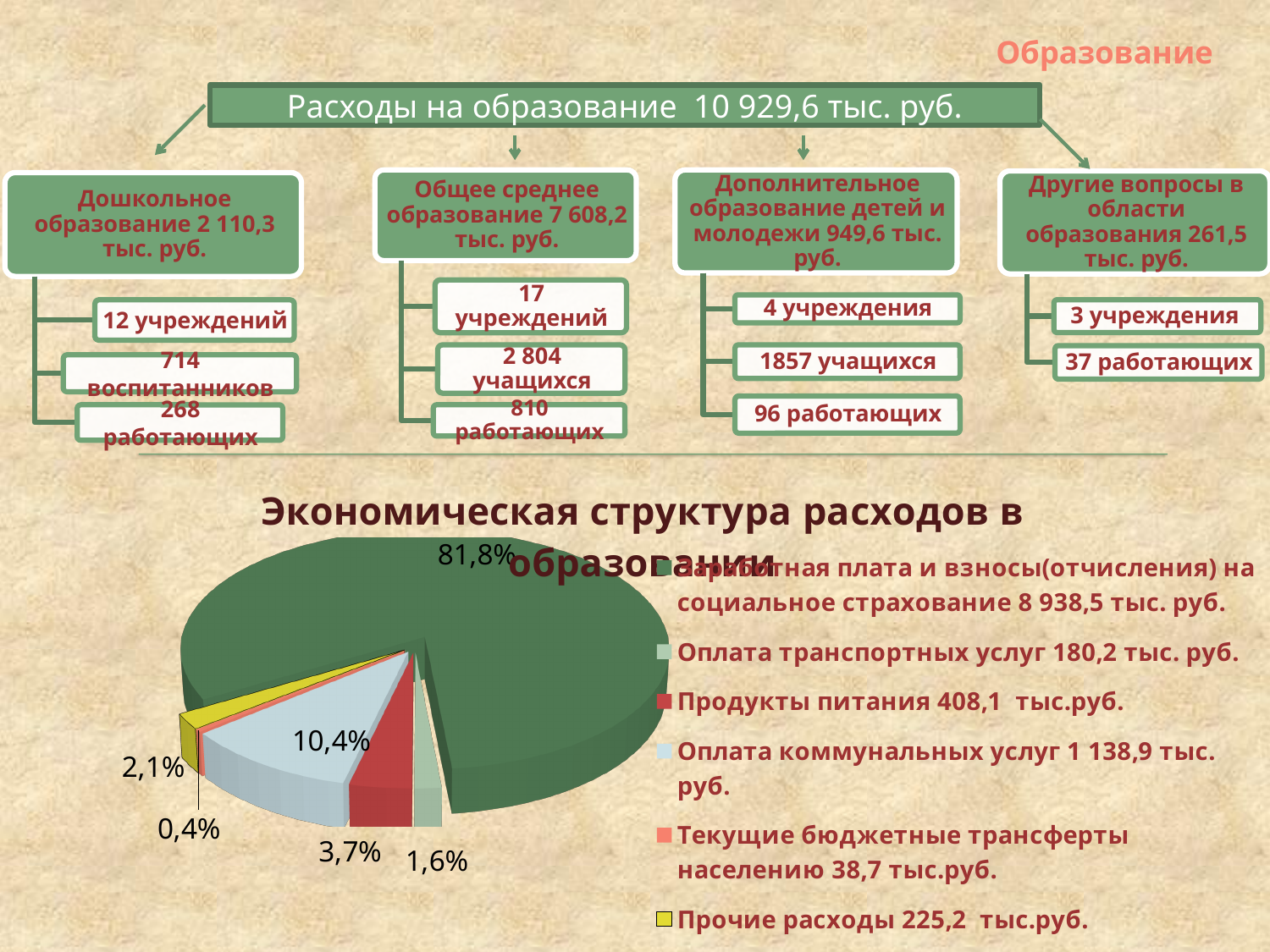
Which category has the smallest slice of the pie? Текущие бюджетные трансферты населению What kind of chart is shown on the slide? pie chart According to the legend, what amount in тыс. руб. is given for Оплата коммунальных услуг? 1 138,9 тыс. руб. Which slice is larger: Прочие расходы or Оплата транспортных услуг? Прочие расходы How many entries does the chart legend list? 6 What share of the pie is labelled for Продукты питания? 3,7% Which category has the largest slice of the pie? Заработная плата и взносы (отчисления) на социальное страхование What share of the pie is labelled for Заработная плата и взносы (отчисления) на социальное страхование? 81,8% What share of the pie is labelled for Оплата коммунальных услуг? 10,4% What is the difference in percentage points between the Заработная плата slice (81,8%) and the Оплата коммунальных услуг slice (10,4%)? 71,4% What is the title of the chart on the slide? Экономическая структура расходов в образовании How many slices does the pie chart have? 6